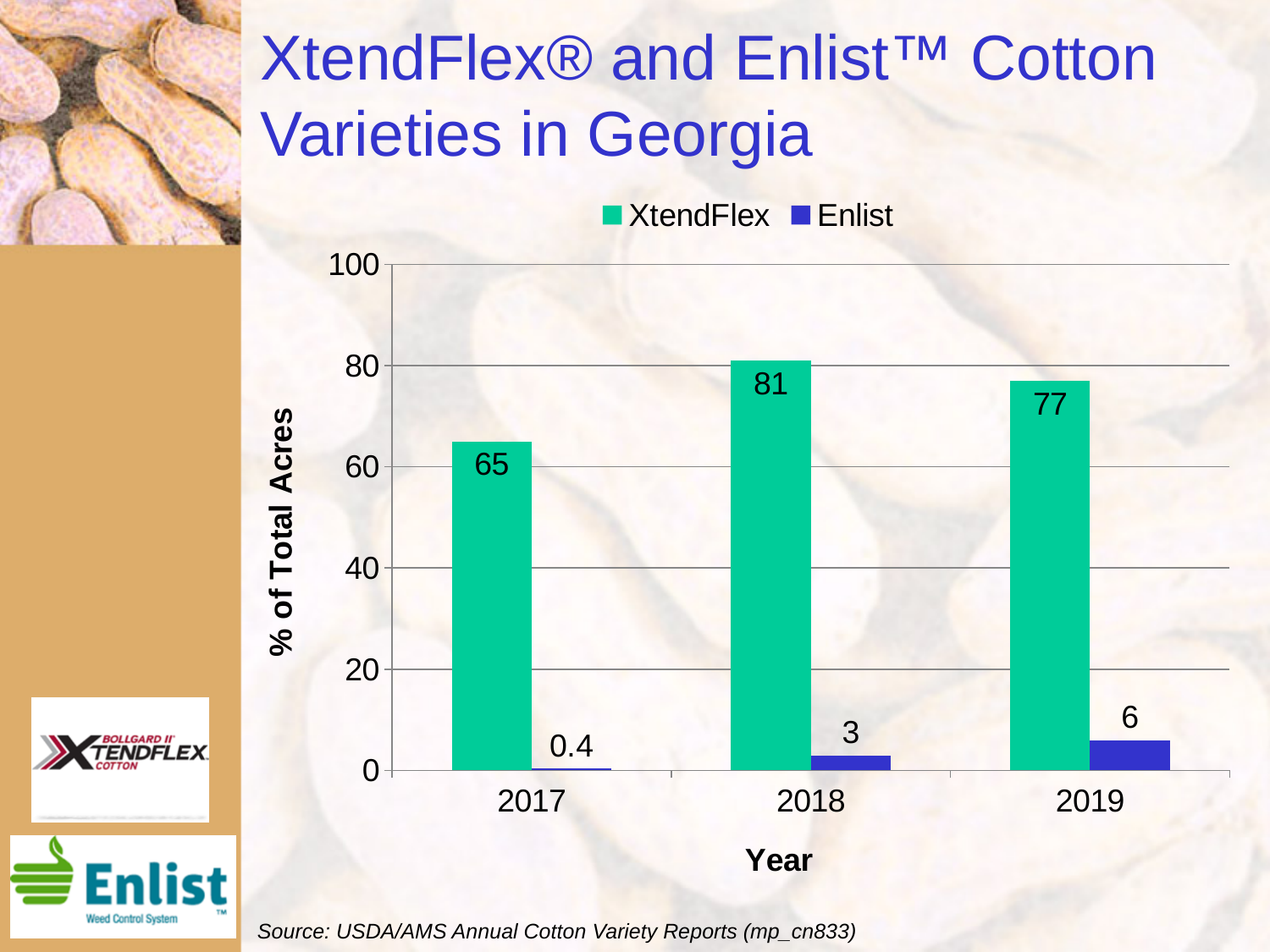
What is the difference between the XtendFlex values for 2018 and 2017? 16 In which year is the Enlist value lowest? 2017 How many years are shown on the x axis? 3 What is the Enlist value for 2019? 6 Does the Enlist value rise or fall from 2017 to 2019? Rise What kind of chart is shown on the slide? Bar chart What is the label of the y axis? % of Total Acres How many series does the legend list? 2 Which is larger, the XtendFlex value for 2019 or the XtendFlex value for 2017? 2019 What is the XtendFlex value for 2018? 81 In which year is the XtendFlex value highest? 2018 What is the Enlist value for 2017? 0.4